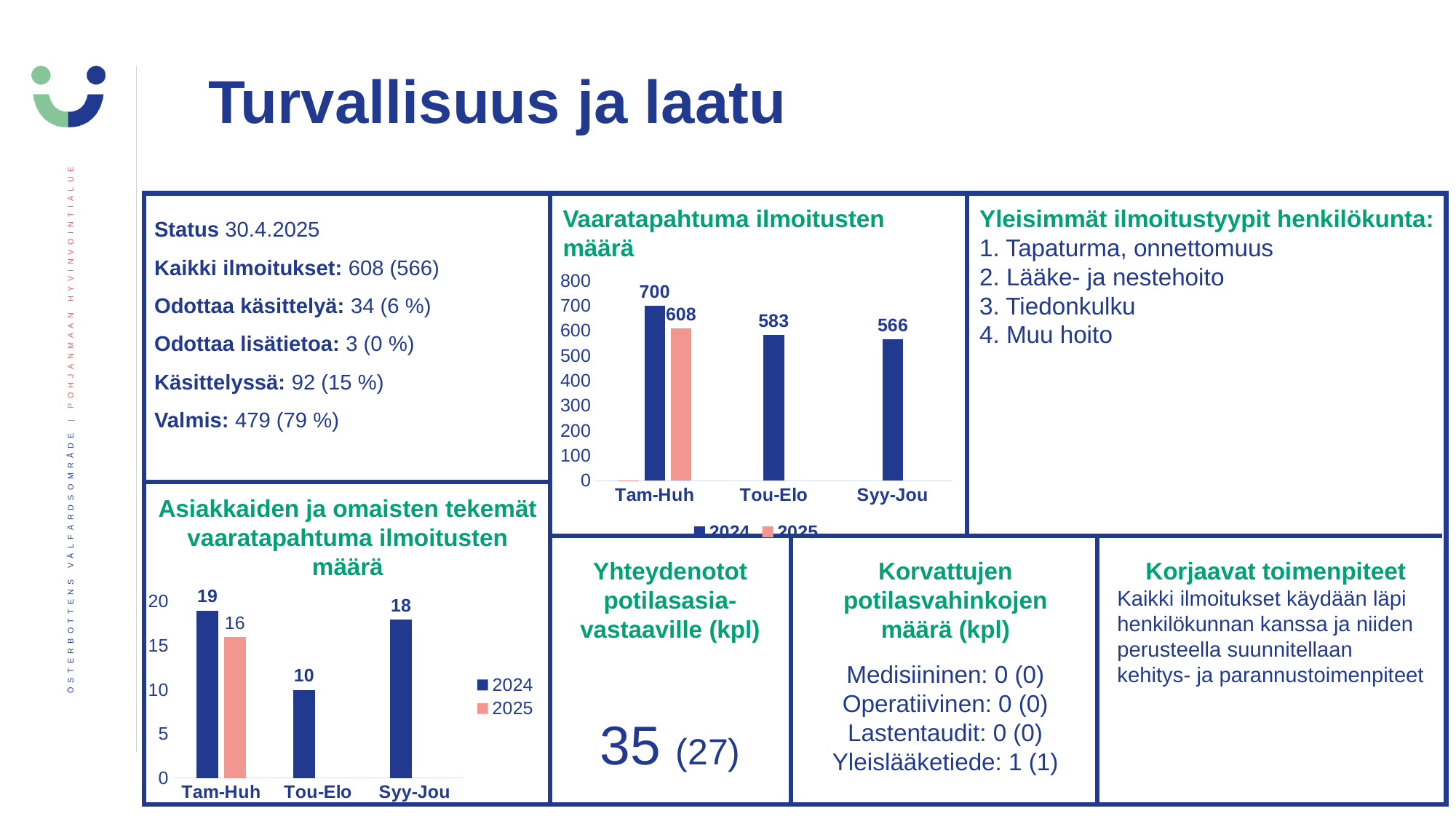
In the 'Asiakkaiden ja omaisten tekemät vaaratapahtuma ilmoitusten määrä' chart, what is the 2024 value for Tou-Elo? 10 In the 'Asiakkaiden ja omaisten tekemät vaaratapahtuma ilmoitusten määrä' chart, which period has the highest 2024 value? Tam-Huh How many series does the legend of the 'Vaaratapahtuma ilmoitusten määrä' chart list? 2 In the 'Vaaratapahtuma ilmoitusten määrä' chart, what is the 2024 value for Tam-Huh? 700 In the 'Vaaratapahtuma ilmoitusten määrä' chart, what is the 2025 value for Tam-Huh? 608 In the 'Asiakkaiden ja omaisten tekemät vaaratapahtuma ilmoitusten määrä' chart, which is larger for Tam-Huh: the 2024 value or the 2025 value? 2024 In the 'Vaaratapahtuma ilmoitusten määrä' chart, is the 2024 value for Tou-Elo greater or less than 500? greater In the 'Vaaratapahtuma ilmoitusten määrä' chart, do the 2024 values rise or fall from Tam-Huh to Syy-Jou? fall In the 'Vaaratapahtuma ilmoitusten määrä' chart, what is the difference between the 2024 and 2025 values for Tam-Huh? 92 What type of chart is the 'Asiakkaiden ja omaisten tekemät vaaratapahtuma ilmoitusten määrä' chart? bar chart In the 'Vaaratapahtuma ilmoitusten määrä' chart, which period has the lowest 2024 value? Syy-Jou How many periods are shown on the x axis of the 'Asiakkaiden ja omaisten tekemät vaaratapahtuma ilmoitusten määrä' chart? 3